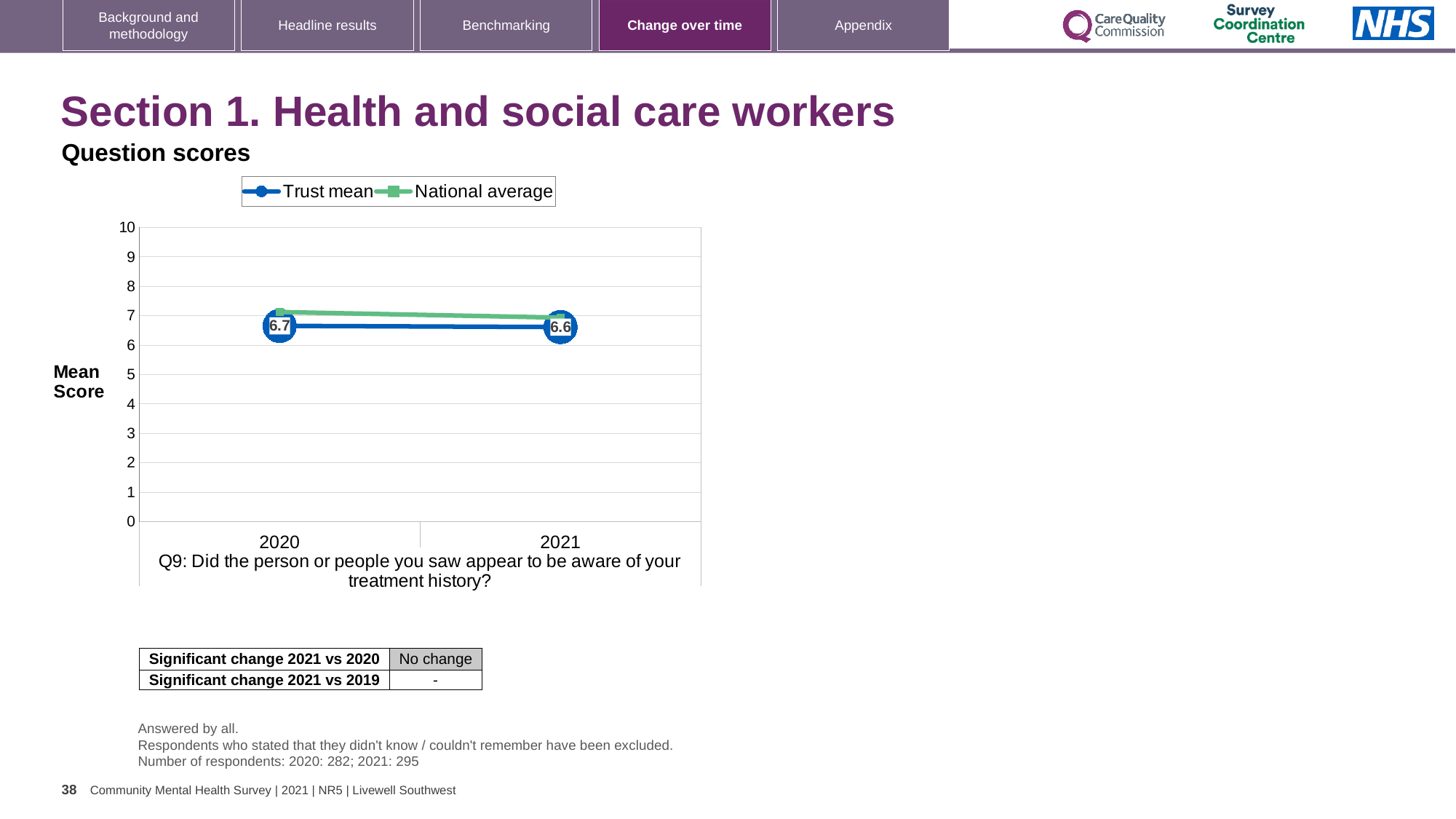
What is the Trust mean score for 2020? 6.7 Which year has the higher Trust mean score, 2020 or 2021? 2020 What are the two series named in the legend? Trust mean and National average What kind of chart is shown on the slide? line chart By how much did the Trust mean score change from 2020 to 2021? 0.1 How many years are plotted on the x axis? 2 How many series does the legend list? 2 What is the Trust mean score for 2021? 6.6 Is the National average for 2020 greater or less than 5? greater What is the label on the y axis of the chart? Mean Score In 2020, which is higher: the Trust mean or the National average? National average Does the Trust mean rise or fall from 2020 to 2021? fall